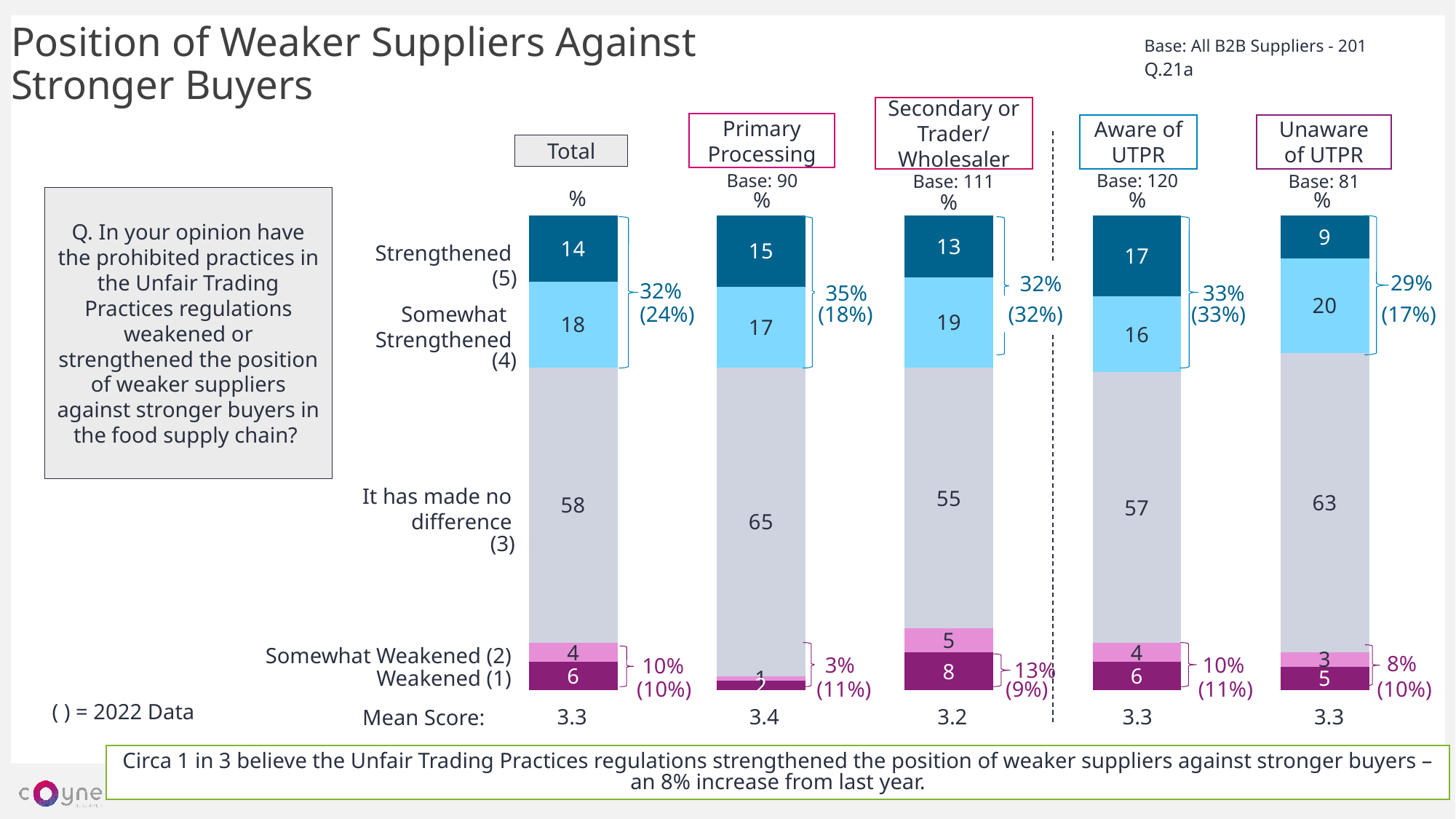
Which is larger: the 'Somewhat Strengthened (4)' percentage for Aware of UTPR or for Unaware of UTPR? Unaware of UTPR How many groups (bars) are shown in the chart? 5 What percentage of the Total group said the regulations 'Strengthened (5)' the position of weaker suppliers? 14 What percentage of Primary Processing suppliers said 'It has made no difference (3)'? 65 What is the Mean Score for the Aware of UTPR group? 3.3 What is the difference between the 'It has made no difference (3)' percentages for Primary Processing and Secondary or Trader/Wholesaler? 10 What is the combined 'Strengthened' plus 'Somewhat Strengthened' percentage shown for the Primary Processing group? 35% What percentage of suppliers Unaware of UTPR said 'Somewhat Strengthened (4)'? 20 What type of chart is used on this slide? Stacked bar chart Which group has the highest percentage for 'It has made no difference (3)'? Primary Processing Which group has the lowest percentage for 'Strengthened (5)'? Unaware of UTPR What percentage of Secondary or Trader/Wholesaler suppliers said 'Weakened (1)'? 8